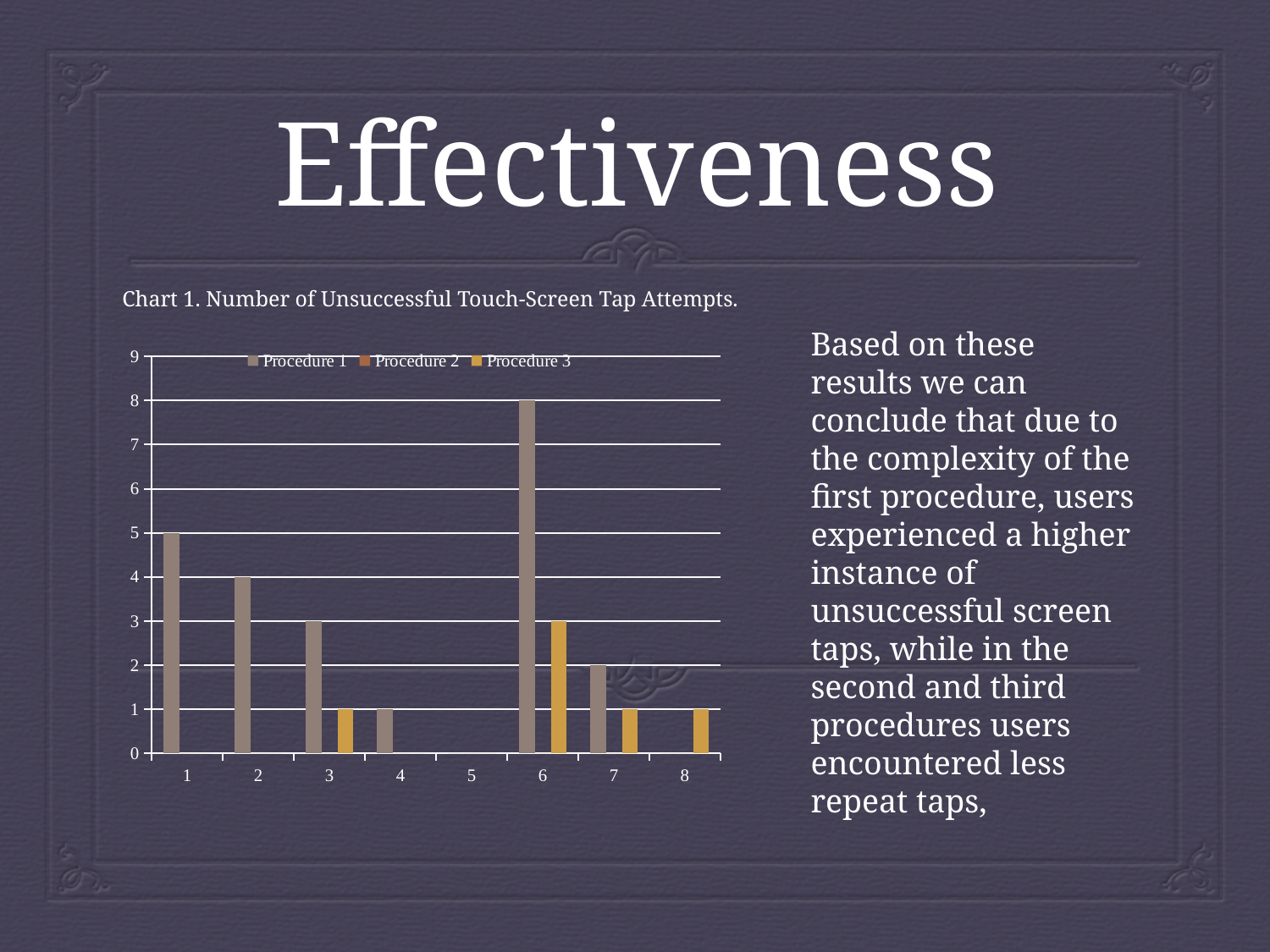
What is the title of the chart on the slide? Chart 1. Number of Unsuccessful Touch-Screen Tap Attempts. What kind of chart is Chart 1? bar chart Which category has the highest Procedure 1 value in Chart 1? 6 What is the value for Procedure 3 at category 6 in Chart 1? 3 Is the value for Procedure 1 at category 6 in Chart 1 greater or less than 7? greater Which category has the highest Procedure 3 value in Chart 1? 6 What is the value for Procedure 1 at category 6 in Chart 1? 8 In Chart 1, which is larger at category 6: the Procedure 1 value or the Procedure 3 value? Procedure 1 In Chart 1, what is the difference between the Procedure 1 value at category 6 and the Procedure 1 value at category 1? 3 How many series does the legend of Chart 1 list? 3 What is the value for Procedure 1 at category 1 in Chart 1? 5 How many categories are shown on the x axis of Chart 1? 8